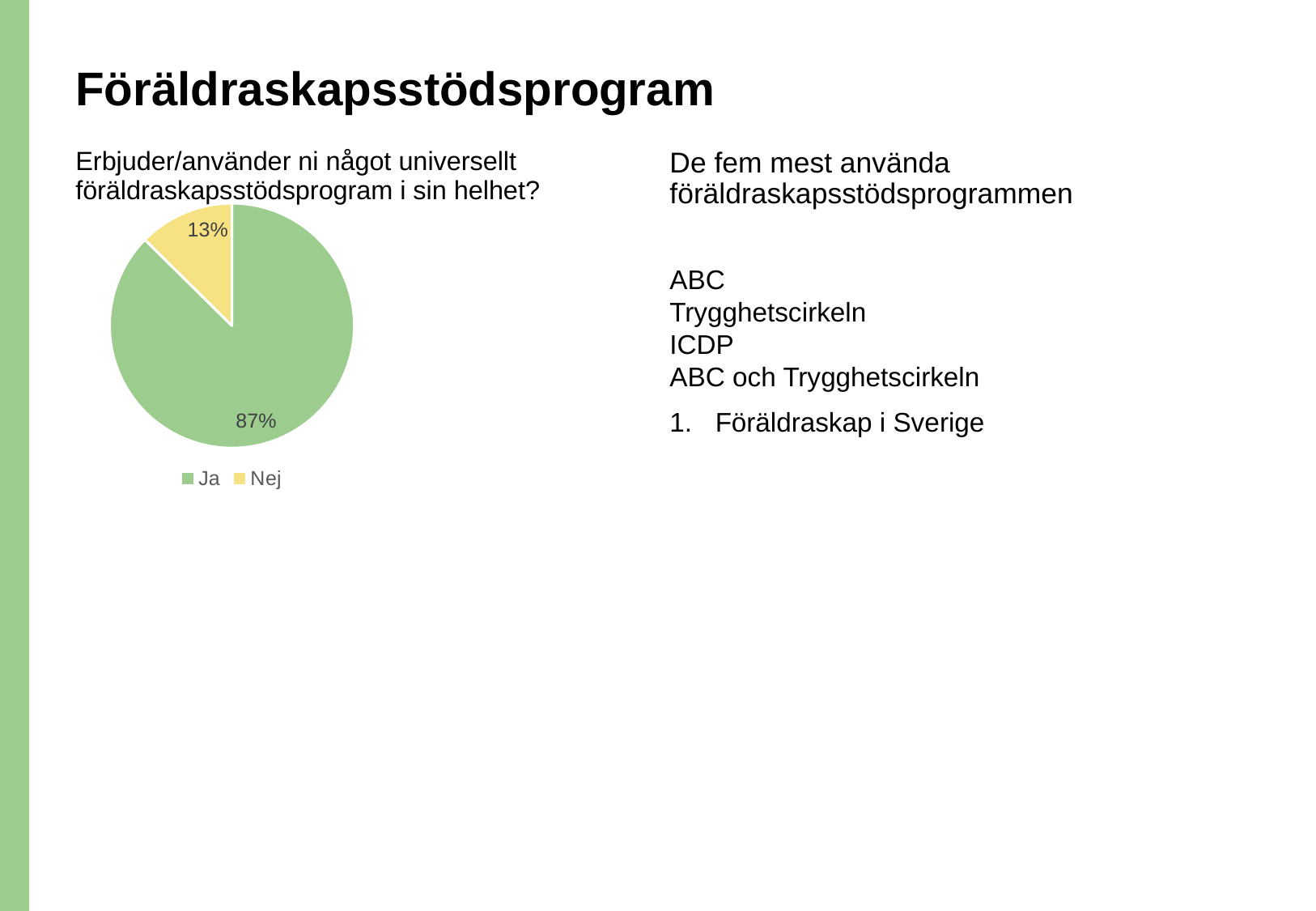
Which slice of the pie chart is the smallest? Nej What percentage of the pie chart is labelled "Ja"? 87% What is the difference in percentage points between the "Ja" and "Nej" slices? 74 What share of the pie does the "Nej" slice represent? 13% How many entries does the legend of the pie chart list? 2 What percentage of the pie chart is labelled "Nej"? 13% What kind of chart is shown on the slide? pie chart Which is larger in the pie chart, "Ja" or "Nej"? Ja What colour is the "Nej" slice in the pie chart? yellow How many slices does the pie chart have? 2 What colour is the "Ja" slice in the pie chart? green Which slice of the pie chart is the largest? Ja